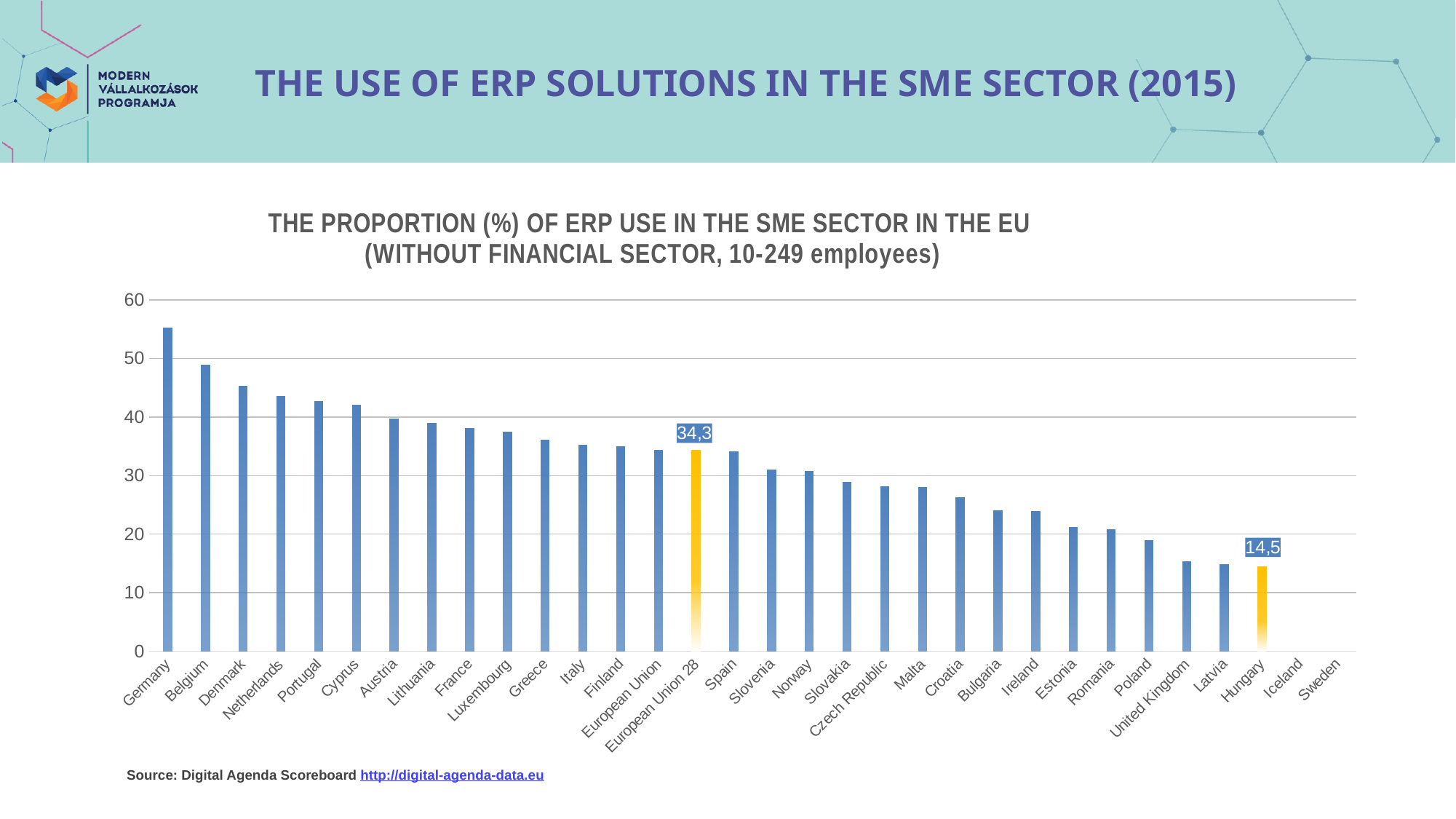
What is the difference between the values for European Union 28 and Hungary? 19,8 Do the values rise or fall from left to right along the x axis? Fall How many category labels are shown on the x axis? 32 Which has a higher value, Germany or Belgium? Germany What is the value shown for Hungary? 14,5 What is the value shown for European Union 28? 34,3 What kind of chart is shown on the slide? Bar chart Is the value for Germany greater or less than 50? greater Which has a higher value, Spain or Slovenia? Spain Is the value for Croatia greater or less than 30? less Which category has the shortest bar plotted in the chart? Hungary Which country has the highest proportion of ERP use in the chart? Germany